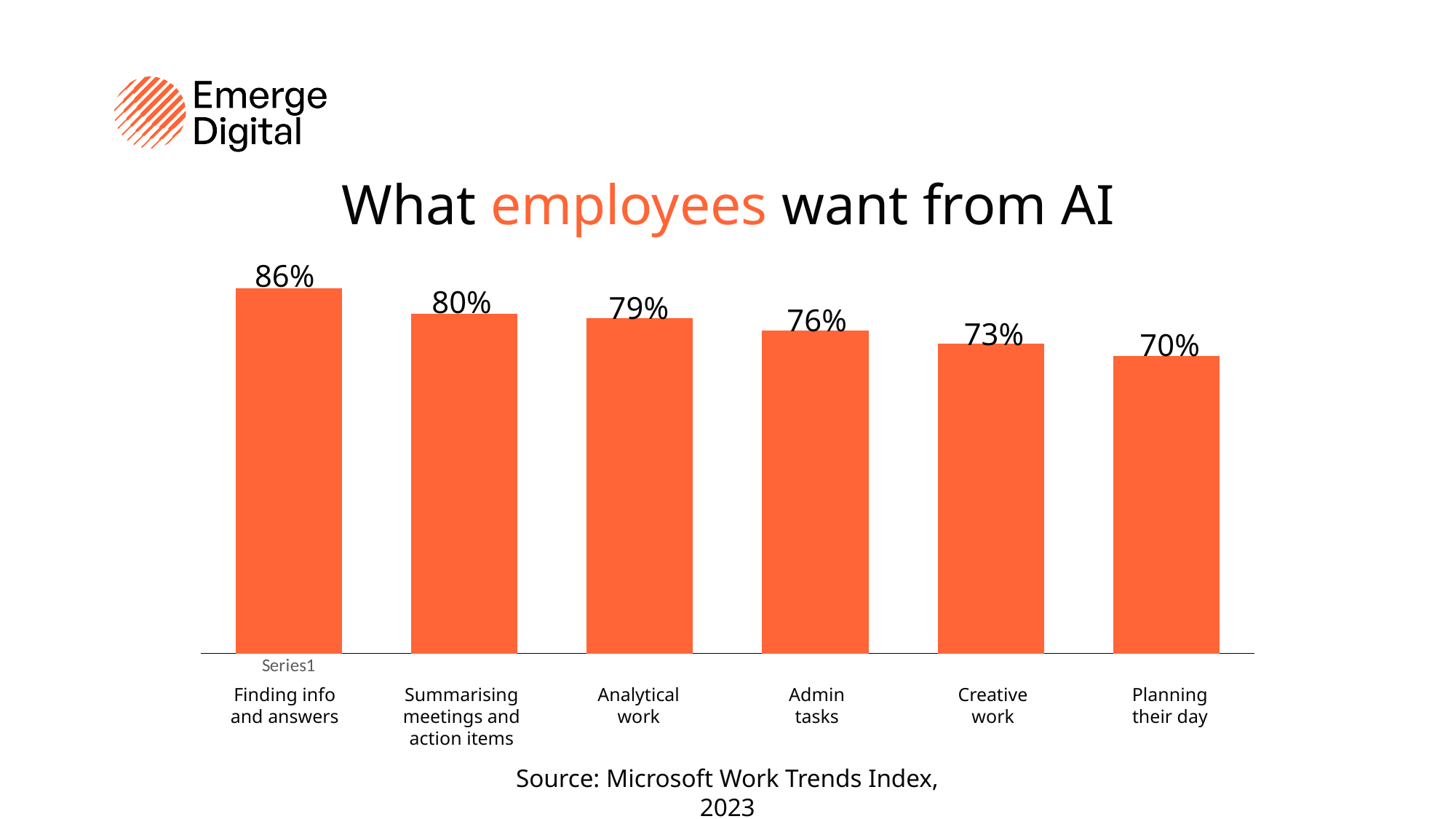
What is the difference between the values for admin tasks and creative work? 3% What is the value for planning their day? 70% What is the difference between the values for finding info and answers and planning their day? 16% Which category has the lowest value? Planning their day Which is larger, the value for admin tasks or the value for creative work? Admin tasks What is the value shown for summarising meetings and action items? 80% How many categories are shown in the chart? 6 What percentage of employees want AI for finding info and answers? 86% Which category has the highest value? Finding info and answers Do the values rise or fall from left to right across the categories? Fall What kind of chart is shown on the slide? Bar chart What percentage is shown for analytical work? 79%